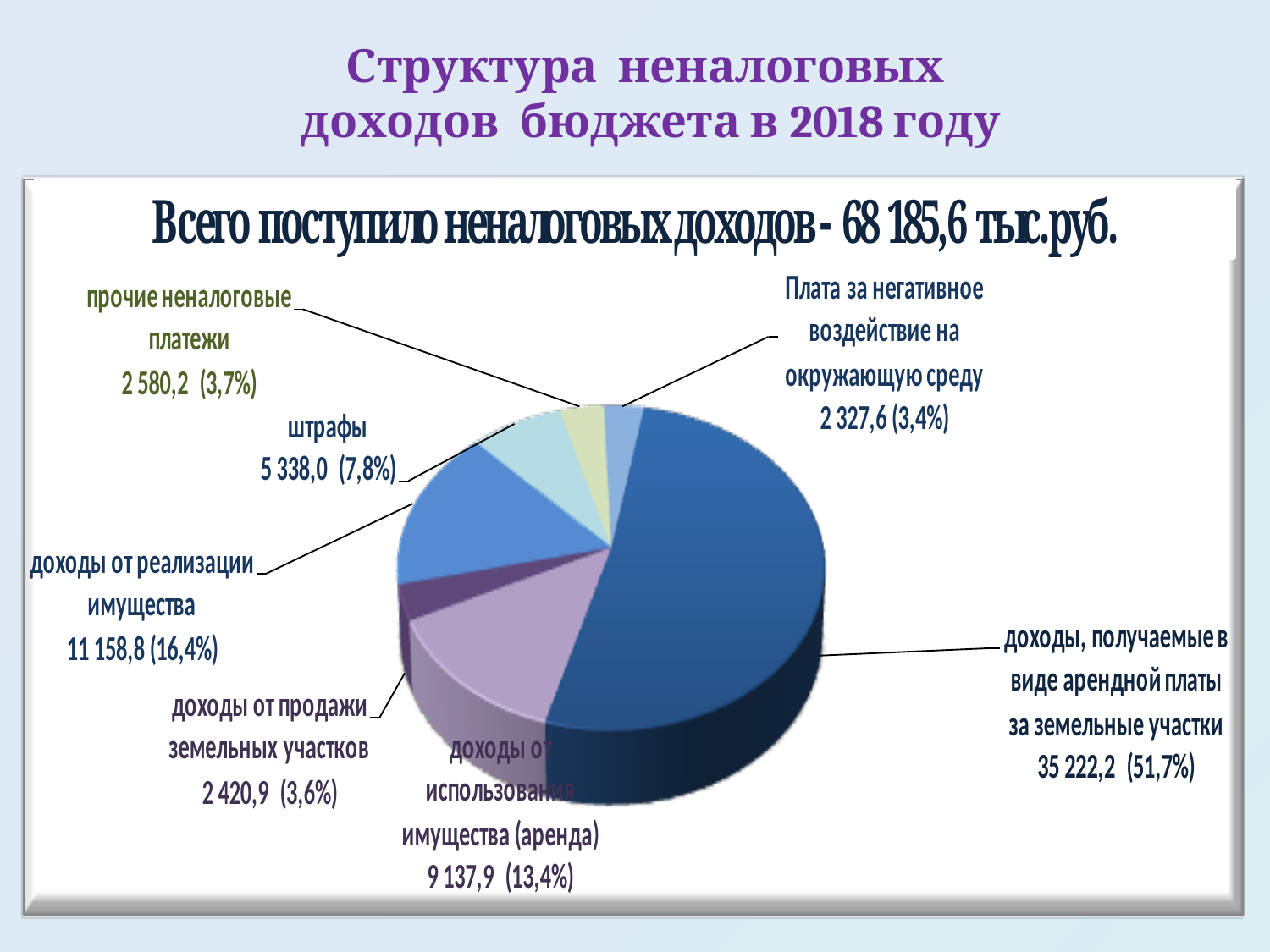
What type of chart is shown on the slide? pie chart Which category has the largest slice of the pie? доходы, получаемые в виде арендной платы за земельные участки What total amount of non-tax revenue is stated in the chart title? 68 185,6 тыс.руб. What is the difference in percentage points between «доходы от реализации имущества» (16,4%) and «доходы от использования имущества (аренда)» (13,4%)? 3,0% How many slices does the pie chart have? 7 What is the value shown for «прочие неналоговые платежи»? 2 580,2 What share of the pie does «доходы, получаемые в виде арендной платы за земельные участки» represent? 51,7% Which is larger: «штрафы» or «доходы от продажи земельных участков»? штрафы What is the value shown for «доходы от реализации имущества»? 11 158,8 What percentage is shown for «доходы от использования имущества (аренда)»? 13,4% Which category has the smallest slice of the pie? Плата за негативное воздействие на окружающую среду What is the value shown for «штрафы»? 5 338,0